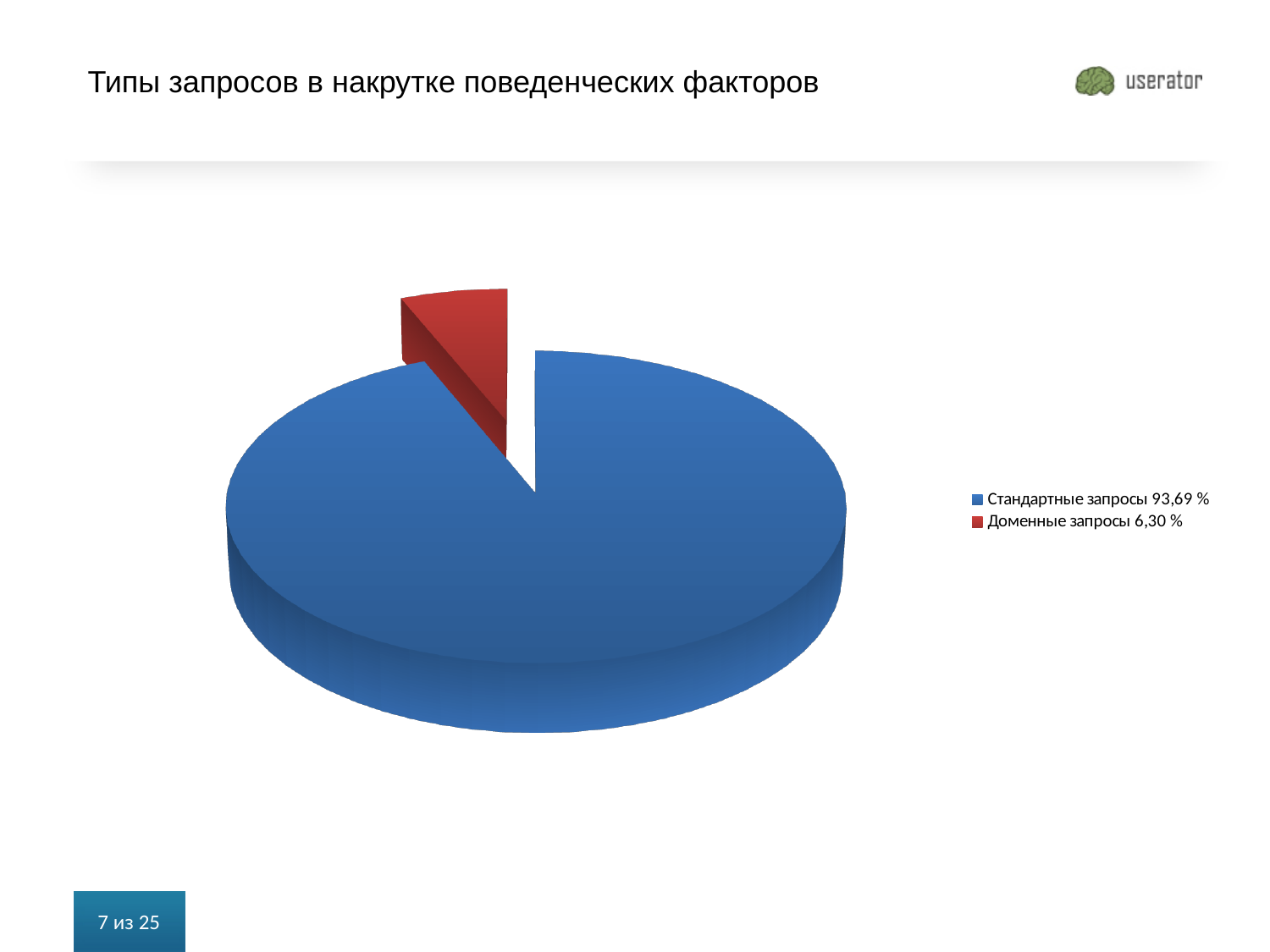
How many slices does the pie chart have? 2 Which is larger: Стандартные запросы or Доменные запросы? Стандартные запросы Which category has the largest slice of the pie? Стандартные запросы What colour is the slice for Доменные запросы? Red How many entries does the legend list? 2 What is the title of the slide containing the pie chart? Типы запросов в накрутке поведенческих факторов What kind of chart is shown on the slide? Pie chart Which category has the smallest slice of the pie? Доменные запросы What share of the pie is Доменные запросы? 6,30 % What share of the pie is Стандартные запросы? 93,69 % What is the difference in percentage points between Стандартные запросы and Доменные запросы? 87,39